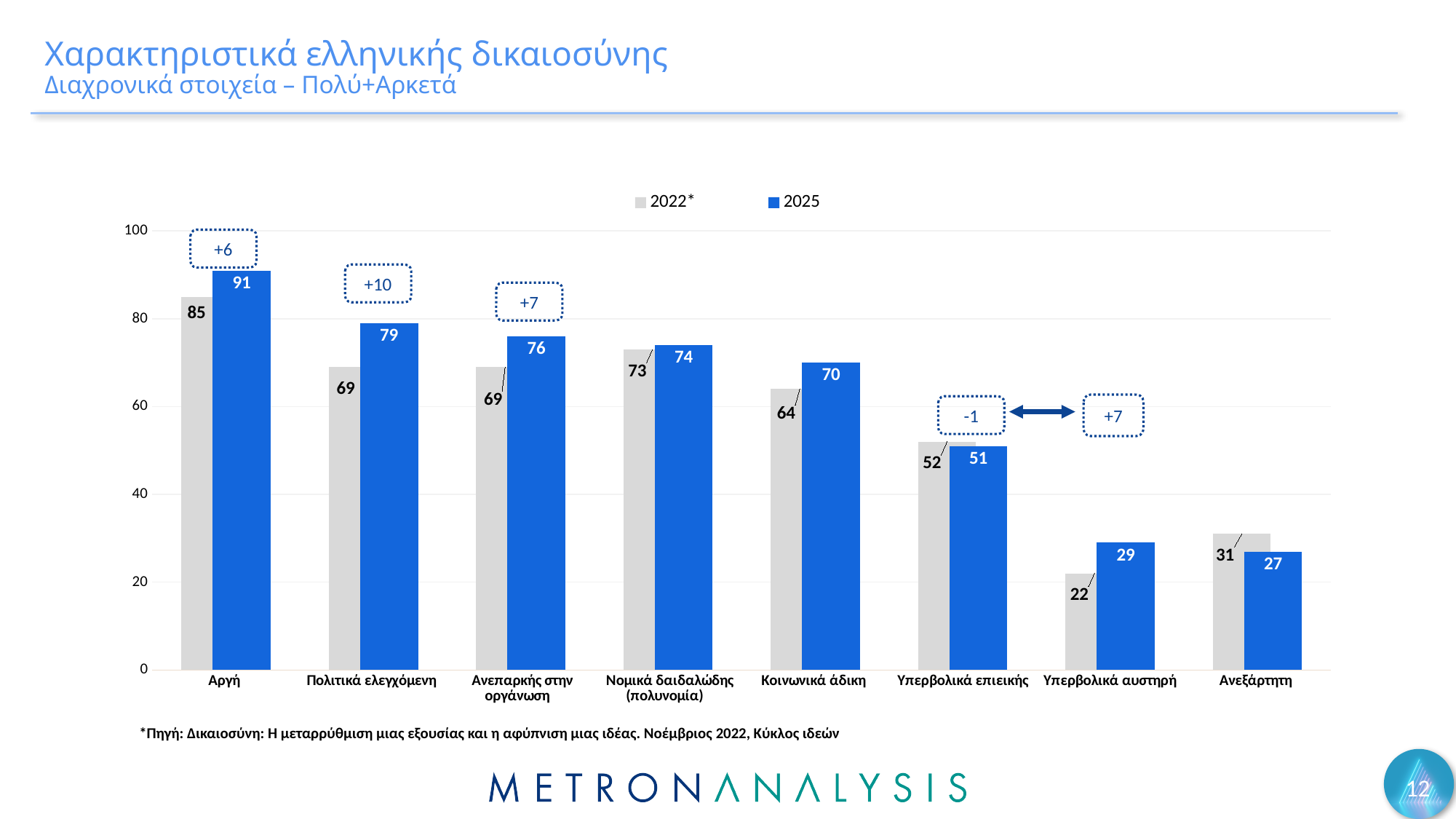
Which series is shown in blue in the legend? 2025 How many series does the legend list? 2 What is the 2025 value for Αργή? 91 What is the difference between the 2025 and 2022* values for Πολιτικά ελεγχόμενη? 10 What is the 2022* value for Κοινωνικά άδικη? 64 How many categories are shown on the x axis? 8 What is the 2025 value for Υπερβολικά αυστηρή? 29 Which category has the lowest 2022* value? Υπερβολικά αυστηρή For Ανεξάρτητη, which is larger: the 2022* value or the 2025 value? 2022* Which category has the highest 2025 value? Αργή What kind of chart is shown on the slide? Bar chart What is the 2022* value for Νομικά δαιδαλώδης (πολυνομία)? 73